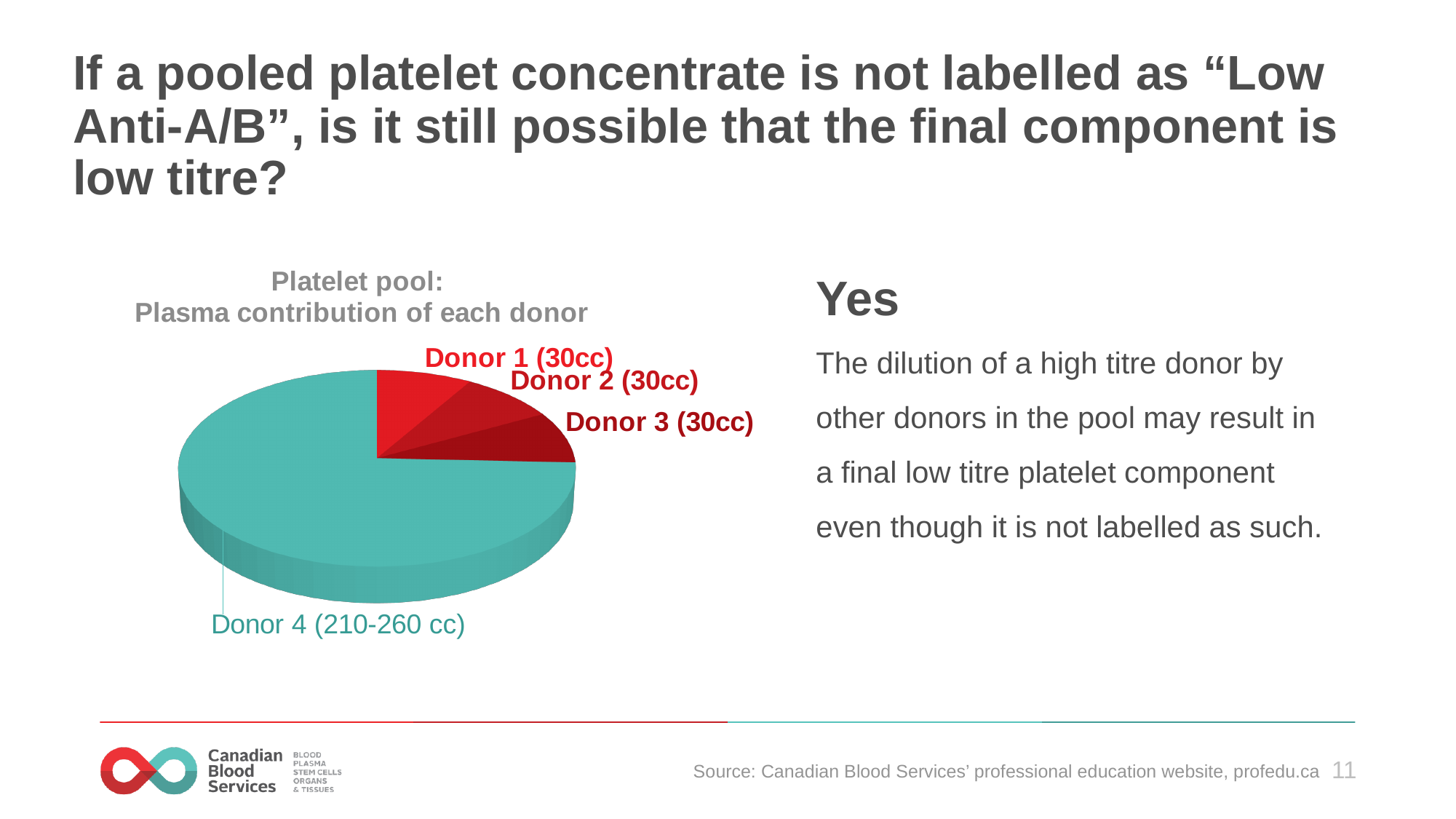
How many donors contribute 30cc each? 3 What colour is the Donor 4 slice of the pie chart? teal What is the plasma contribution of Donor 4? 210-260 cc Which donor contributes the largest share of plasma to the pool? Donor 4 What kind of chart is shown on the slide? pie chart Do Donor 1 and Donor 2 contribute the same amount of plasma? yes Which contributes more plasma, Donor 4 or Donor 1? Donor 4 What is the plasma contribution of Donor 2? 30cc How many donors (slices) are shown in the pie chart? 4 What is the title of the pie chart? Platelet pool: Plasma contribution of each donor What is the plasma contribution of Donor 1? 30cc What is the plasma contribution of Donor 3? 30cc